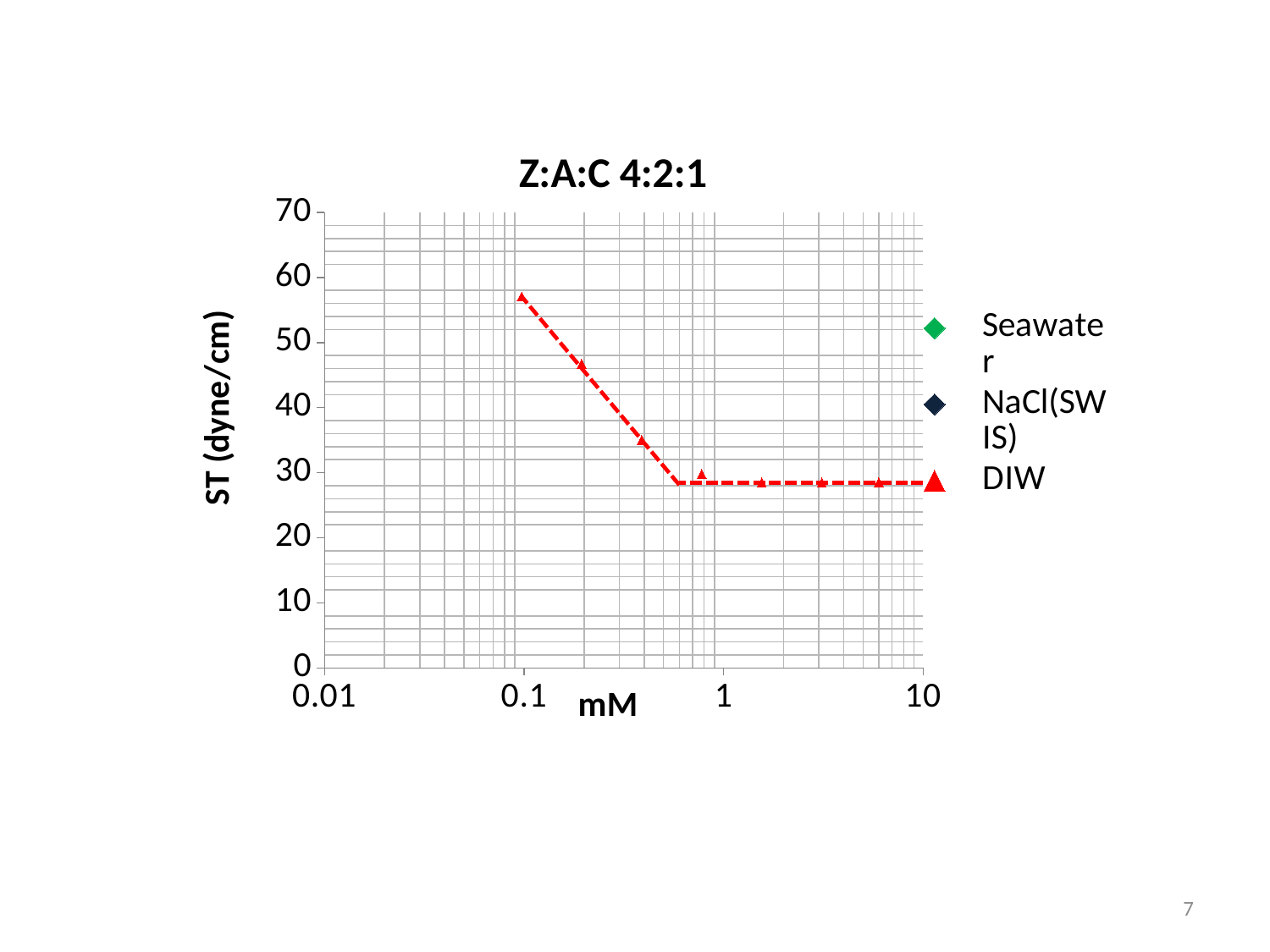
What kind of chart is shown on the slide? line chart Which is larger, the DIW value at 0.1 mM or at 10 mM? 0.1 mM What is the label of the y axis? ST (dyne/cm) Is the DIW value at 10 mM greater or less than 40? less Is the DIW value at 1 mM greater or less than 40? less Which series is plotted with red triangles? DIW Do the DIW values rise or fall as mM increases from 0.1 to 1? fall What is the title of the chart? Z:A:C 4:2:1 How many series does the legend list? 3 Is the DIW value at 0.1 mM greater or less than 50? greater At which mM value is the DIW surface tension highest? 0.1